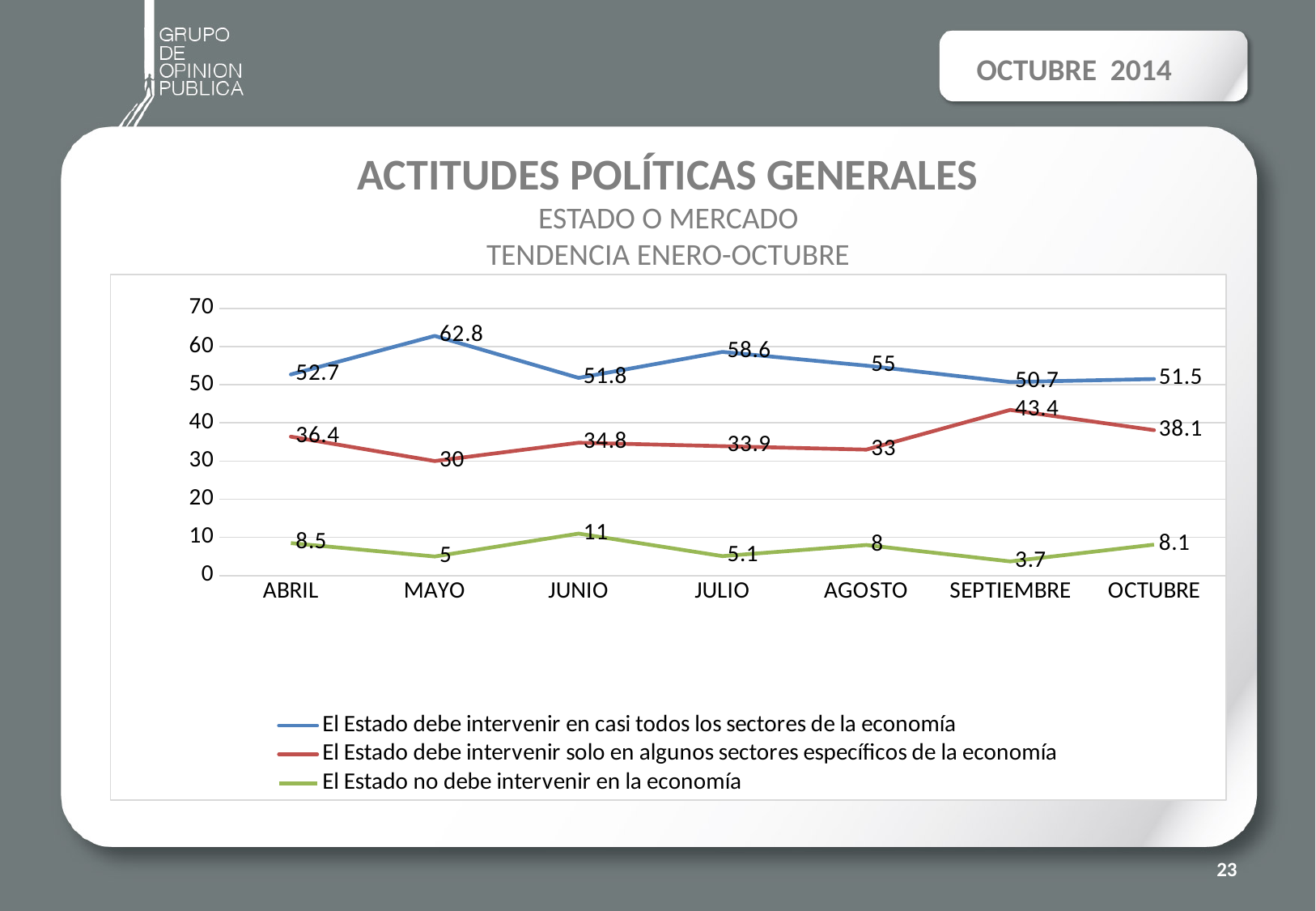
Which is larger for 'El Estado debe intervenir solo en algunos sectores específicos de la economía': the value in ABRIL or the value in MAYO? ABRIL What colour is the line for 'El Estado no debe intervenir en la economía'? green How many series does the legend list? 3 What kind of chart is shown on the slide? line chart How many months are shown on the x axis? 7 What is the value for 'El Estado no debe intervenir en la economía' in JUNIO? 11 What is the value for 'El Estado debe intervenir en casi todos los sectores de la economía' in MAYO? 62.8 In which month is 'El Estado no debe intervenir en la economía' lowest? SEPTIEMBRE What is the value for 'El Estado debe intervenir solo en algunos sectores específicos de la economía' in SEPTIEMBRE? 43.4 Does the 'El Estado debe intervenir en casi todos los sectores de la economía' series rise or fall from MAYO to JUNIO? fall What is the difference between the OCTUBRE values of 'El Estado debe intervenir en casi todos los sectores de la economía' and 'El Estado debe intervenir solo en algunos sectores específicos de la economía'? 13.4 In which month is 'El Estado debe intervenir en casi todos los sectores de la economía' highest? MAYO